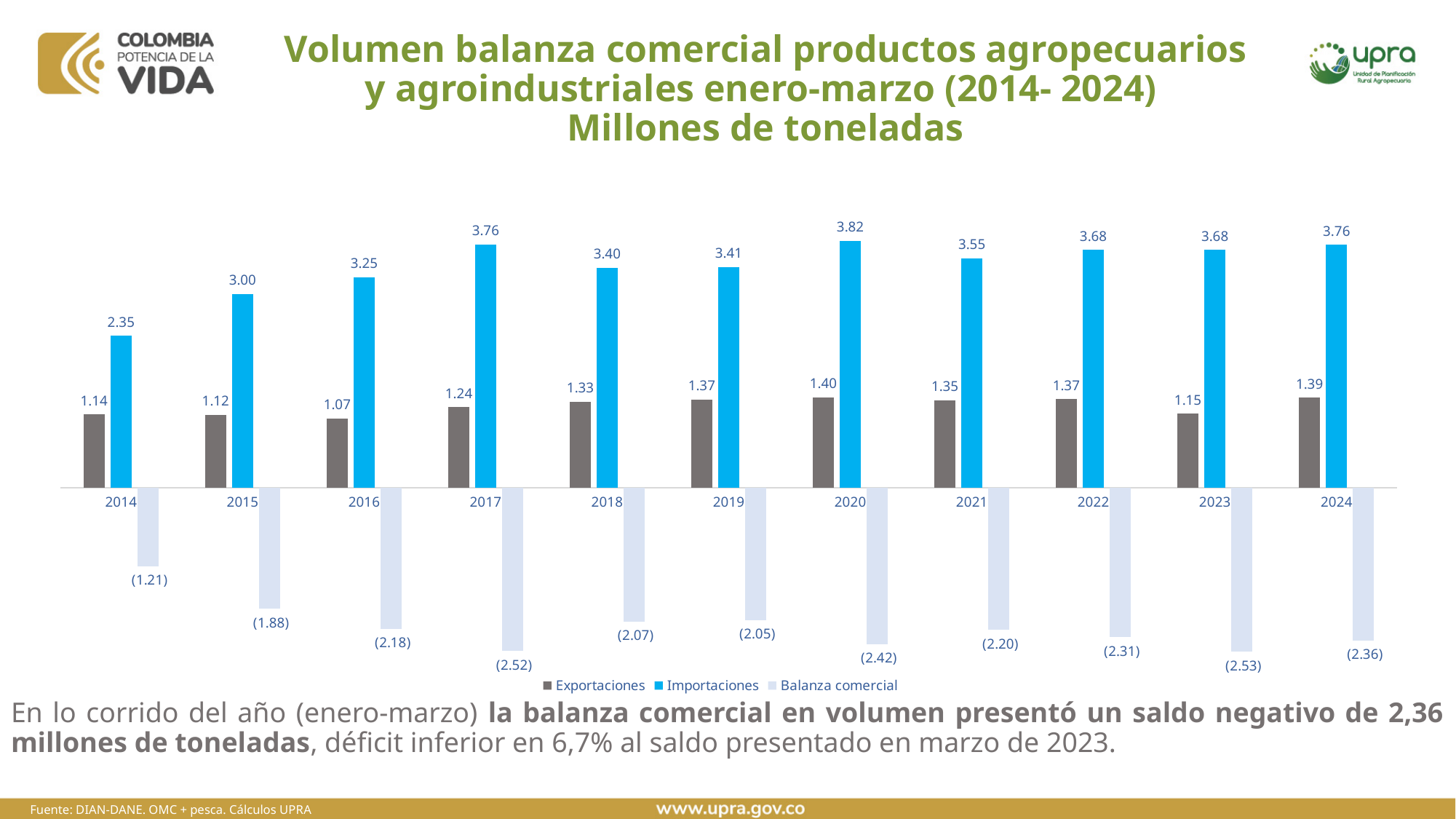
Which is larger, Exportaciones in 2020 or Exportaciones in 2023? Exportaciones in 2020 How many years are shown on the x axis? 11 How many series does the legend list? 3 Do the Importaciones values rise or fall from 2014 to 2017? Rise What is the value of Balanza comercial for 2024? (2.36) What kind of chart is shown on the slide? Bar chart What is the value of Importaciones for 2020? 3.82 Which year has the highest Importaciones value? 2020 What is the difference between Importaciones and Exportaciones in 2014? 1.21 Which year has the lowest Exportaciones value? 2016 What is the value of Exportaciones for 2016? 1.07